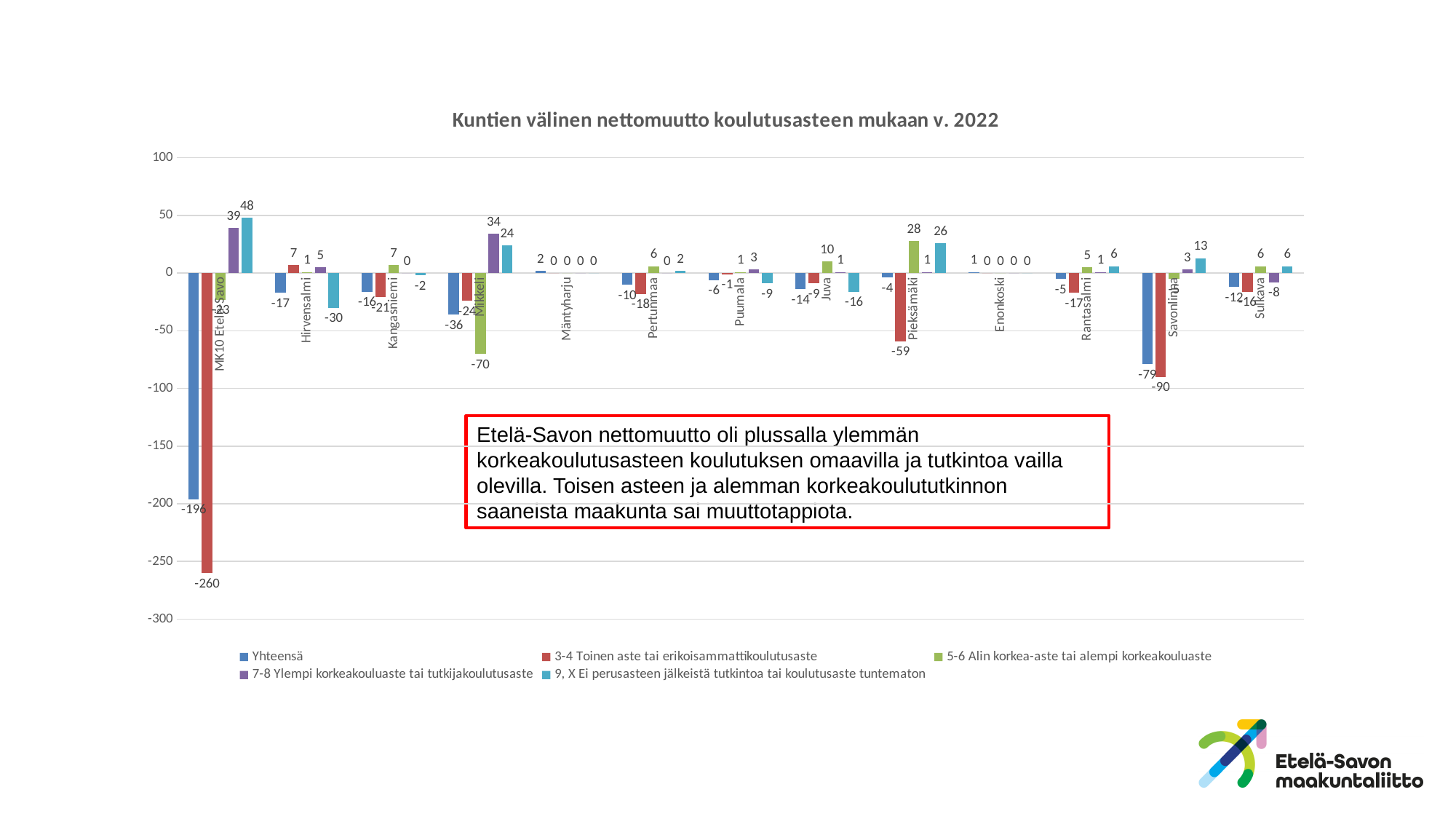
For Mikkeli, what is the difference between the '7-8 Ylempi korkeakouluaste tai tutkijakoulutusaste' value and the '9, X Ei perusasteen jälkeistä tutkintoa tai koulutusaste tuntematon' value? 10 Which is larger: the '9, X Ei perusasteen jälkeistä tutkintoa tai koulutusaste tuntematon' value for Hirvensalmi or for Kangasniemi? Kangasniemi What is the value of the '3-4 Toinen aste tai erikoisammattikoulutusaste' series for MK10 Etelä-Savo? -260 Which category has the lowest value in the '5-6 Alin korkea-aste tai alempi korkeakouluaste' series? Mikkeli What is the value of the '9, X Ei perusasteen jälkeistä tutkintoa tai koulutusaste tuntematon' series for Pieksämäki? 26 What kind of chart is shown on the slide? Bar chart Which municipality has the lowest Yhteensä value? MK10 Etelä-Savo How many series does the legend list? 5 What is the Yhteensä value for Savonlinna? -79 Which category has the highest value in the '9, X Ei perusasteen jälkeistä tutkintoa tai koulutusaste tuntematon' series? MK10 Etelä-Savo How many municipalities/categories are shown on the x axis? 13 What is the title of the chart? Kuntien välinen nettomuutto koulutusasteen mukaan v. 2022